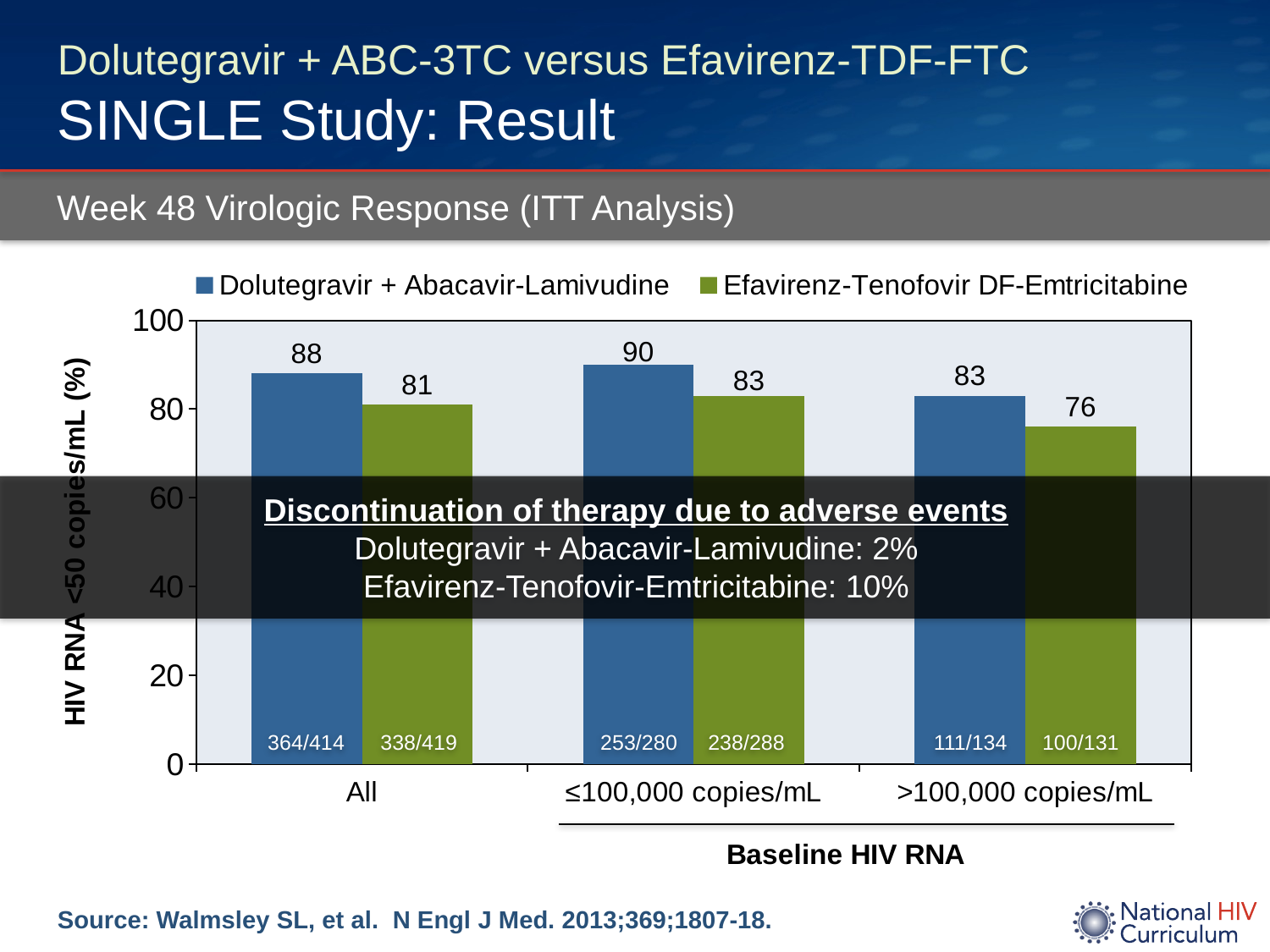
What is the difference between the Dolutegravir + Abacavir-Lamivudine values for All and ≤100,000 copies/mL? 2 Which category has the highest value for Dolutegravir + Abacavir-Lamivudine? ≤100,000 copies/mL Which category has the lowest value for Efavirenz-Tenofovir DF-Emtricitabine? >100,000 copies/mL What is the difference between the two series in the >100,000 copies/mL category? 7 What is the y-axis label of the chart? HIV RNA <50 copies/mL (%) What is the value for Efavirenz-Tenofovir DF-Emtricitabine in the ≤100,000 copies/mL category? 83 What is the value for Efavirenz-Tenofovir DF-Emtricitabine in the >100,000 copies/mL category? 76 How many series does the legend list? 2 In the All category, which series has the larger value? Dolutegravir + Abacavir-Lamivudine What is the value for Dolutegravir + Abacavir-Lamivudine in the All category? 88 What kind of chart is shown? Bar chart How many categories are shown on the x axis? 3